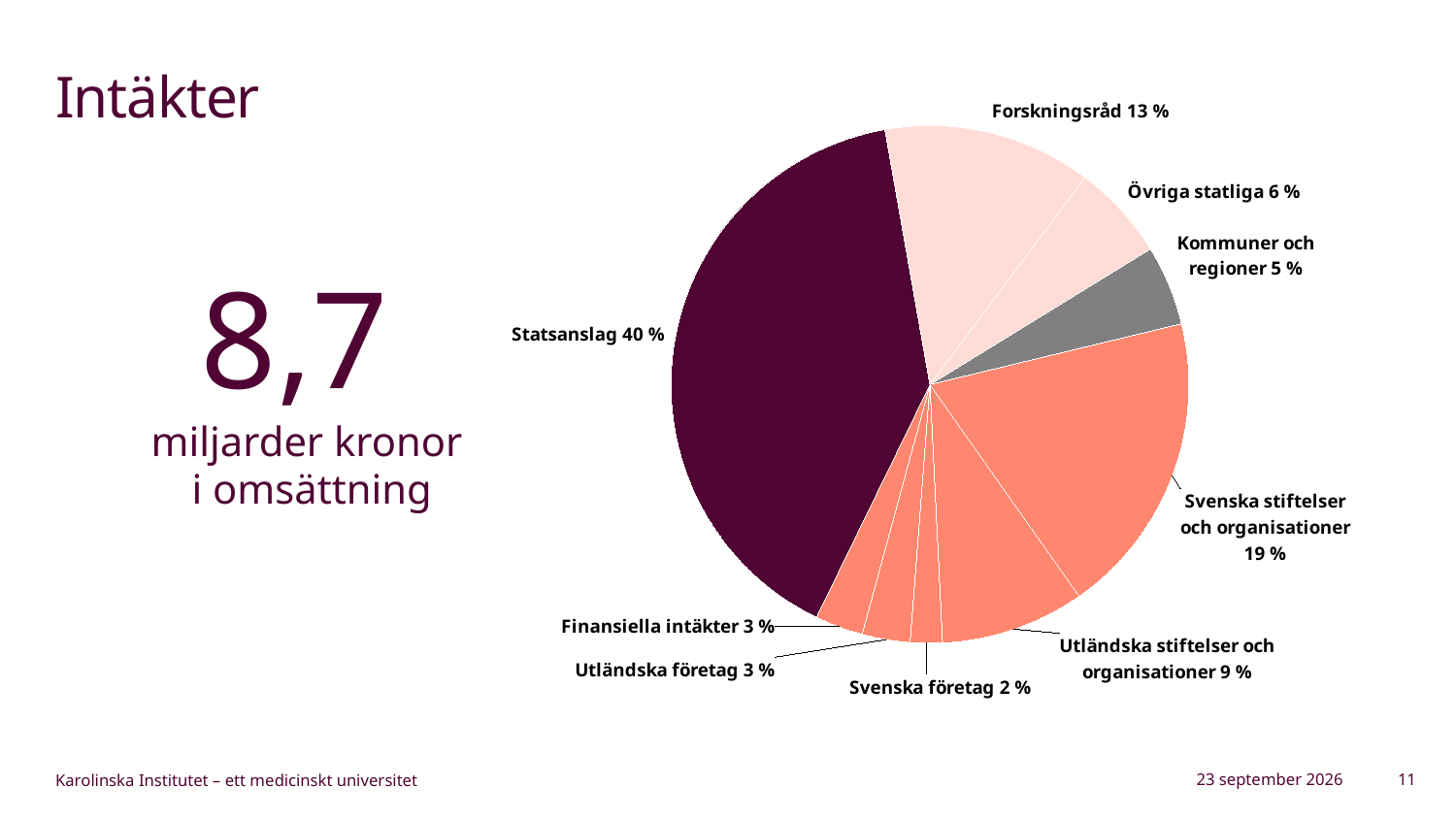
What is the value shown for Utländska stiftelser och organisationer? 9 % What share of the pie does Statsanslag represent? 40 % Which is larger, Forskningsråd or Övriga statliga? Forskningsråd What is the value shown for Kommuner och regioner? 5 % What is the difference in percentage points between Statsanslag and Svenska stiftelser och organisationer? 21 Which category has the smallest slice of the pie? Svenska företag What is the title of the slide containing the pie chart? Intäkter What is the value shown for Forskningsråd? 13 % What kind of chart is shown on the slide? pie chart How many slices does the pie chart have? 9 Which category has the largest slice of the pie? Statsanslag What is the value shown for Svenska stiftelser och organisationer? 19 %